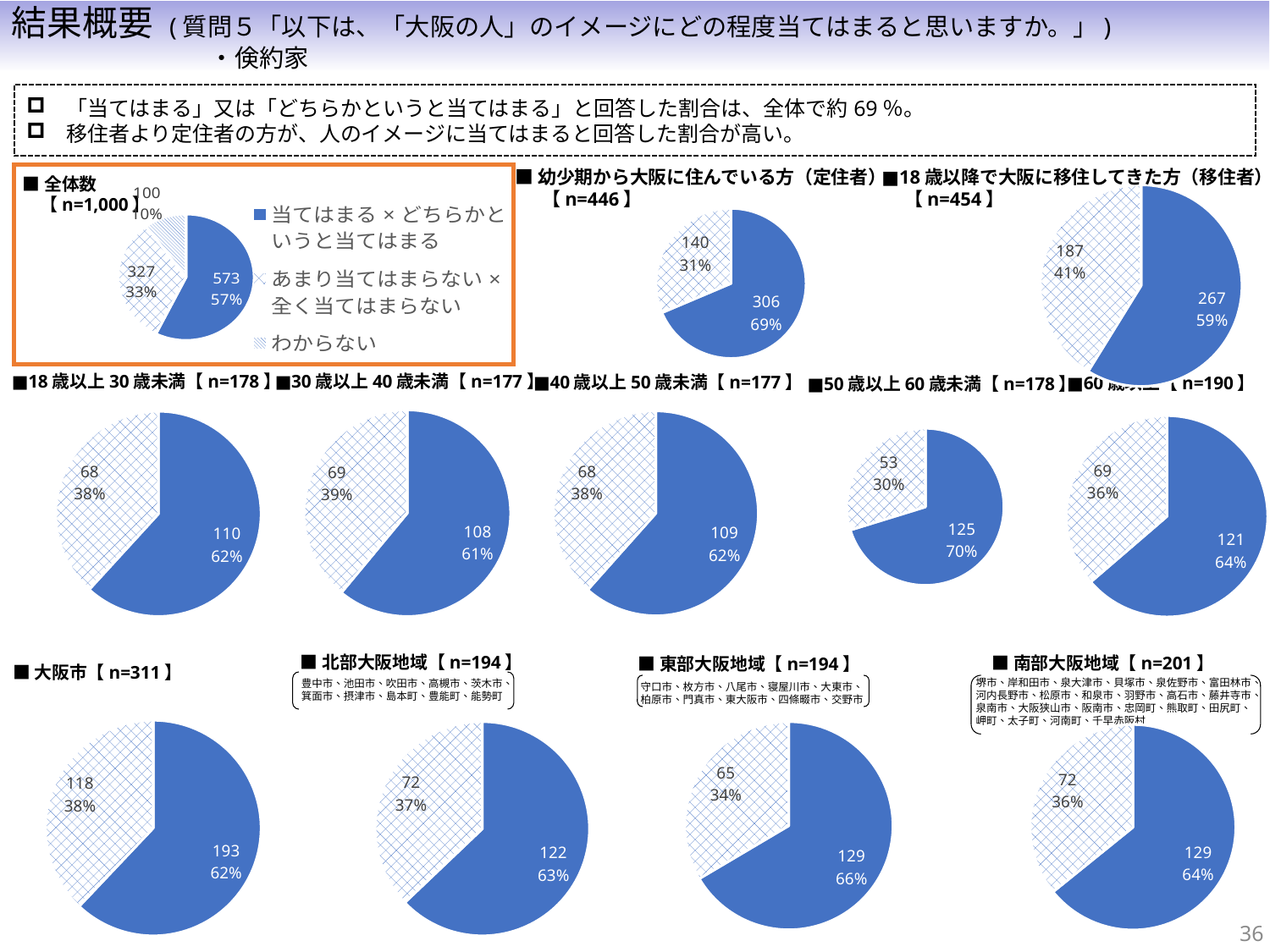
「幼少期から大阪に住んでいる方（定住者）【n=446】」の円グラフで、69%のスライスの値はいくつですか。 306 このスライドのグラフはどの種類のグラフですか。 円グラフ 「18歳以降で大阪に移住してきた方（移住者）【n=454】」の円グラフで、青い塗りつぶしのスライスの割合は何%ですか。 59% 「全体数【n=1,000】」の円グラフで、「わからない」の割合は何%ですか。 10% 「全体数【n=1,000】」の円グラフの凡例には、いくつの項目がありますか。 3 「東部大阪地域【n=194】」の円グラフで、網掛けのスライスの割合は何%ですか。 34% 「30歳以上40歳未満【n=177】」の円グラフで、網掛けのスライスの値はいくつですか。 69 「50歳以上60歳未満【n=178】」の円グラフで、2つのスライスの値の差はいくつですか。 72 「大阪市【n=311】」の円グラフで、青い塗りつぶしのスライスの値はいくつですか。 193 「全体数【n=1,000】」の円グラフで、「当てはまる×どちらかというと当てはまる」の値はいくつですか。 573 「幼少期から大阪に住んでいる方（定住者）」と「18歳以降で大阪に移住してきた方（移住者）」の円グラフで、青い塗りつぶしのスライスの割合が大きいのはどちらですか。 幼少期から大阪に住んでいる方（定住者） 年齢別の5つの円グラフのうち、青い塗りつぶしのスライスの割合が最も大きいのはどのグラフですか。 50歳以上60歳未満【n=178】